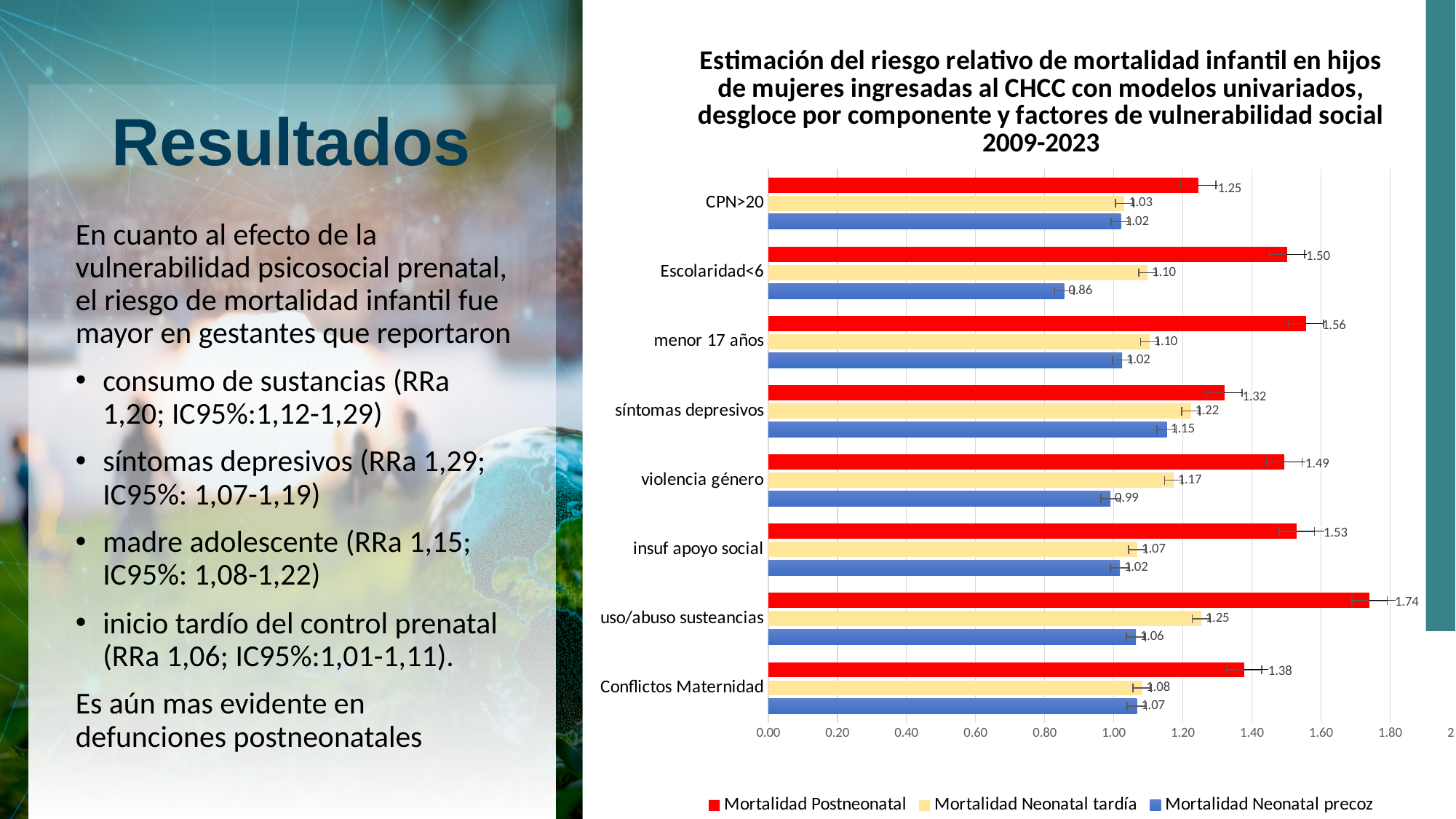
What is the Mortalidad Postneonatal value for uso/abuso susteancias? 1.74 Which category has the lowest Mortalidad Neonatal precoz value? Escolaridad<6 What is the Mortalidad Neonatal precoz value for Escolaridad<6? 0.86 What kind of chart is shown on the slide? Bar chart Is the Mortalidad Postneonatal value for Conflictos Maternidad greater or less than 1.20? greater What is the Mortalidad Neonatal tardía value for síntomas depresivos? 1.22 Which is larger: the Mortalidad Postneonatal value for menor 17 años or for insuf apoyo social? menor 17 años What is the difference between the Mortalidad Postneonatal values for uso/abuso susteancias and CPN>20? 0.49 Which category has the highest Mortalidad Postneonatal value? uso/abuso susteancias How many series does the legend list? 3 Which colour represents Mortalidad Neonatal tardía in the chart? Yellow How many categories are shown on the chart? 8